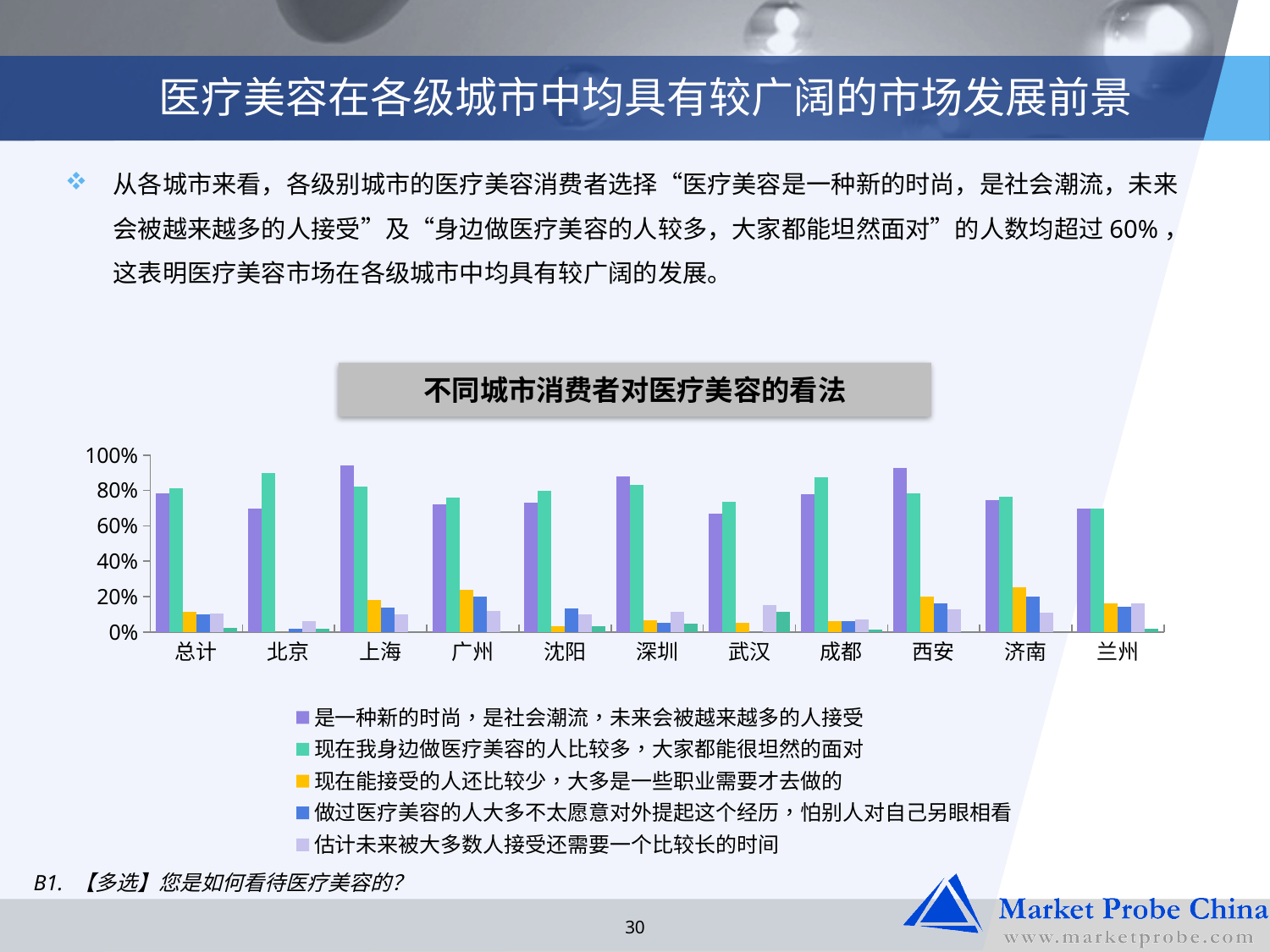
Is the value for 武汉 in the series "是一种新的时尚，是社会潮流，未来会被越来越多的人接受" greater or less than 80%? less How many city categories are shown on the x axis of the chart? 11 Is the value for 上海 in the series "是一种新的时尚，是社会潮流，未来会被越来越多的人接受" greater or less than 80%? greater What kind of chart is shown on the slide? bar chart What is the title of the chart? 不同城市消费者对医疗美容的看法 Is the value for 北京 in the series "现在我身边做医疗美容的人比较多，大家都能很坦然的面对" greater or less than 80%? greater For 北京, which is larger: the value for "是一种新的时尚，是社会潮流，未来会被越来越多的人接受" or the value for "现在我身边做医疗美容的人比较多，大家都能很坦然的面对"? 现在我身边做医疗美容的人比较多，大家都能很坦然的面对 How many series does the chart legend list? 5 For 西安, which is larger: the value for "是一种新的时尚，是社会潮流，未来会被越来越多的人接受" or the value for "现在我身边做医疗美容的人比较多，大家都能很坦然的面对"? 是一种新的时尚，是社会潮流，未来会被越来越多的人接受 What is the highest value shown on the y axis of the chart? 100%